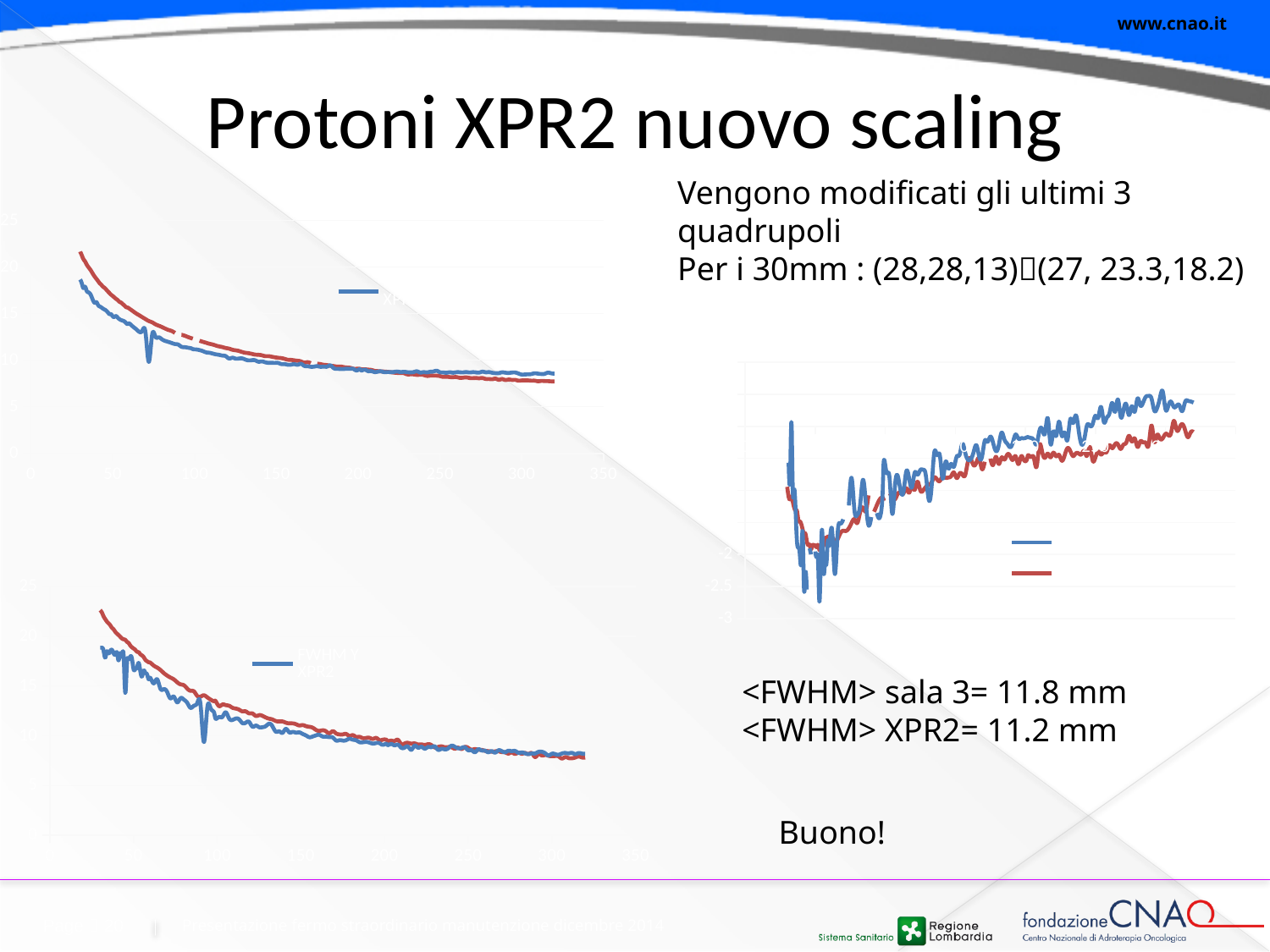
What kind of chart is the chart at the bottom left of the slide? line chart How many lines are plotted in the chart at the bottom left of the slide? 2 What legend entry is shown in the chart at the bottom left of the slide? FWHM Y XPR2 How many lines are plotted in the chart at the top left of the slide? 2 In the chart at the bottom left of the slide, do the plotted values rise or fall along the x axis? fall In the chart at the top left of the slide, do the plotted values rise or fall along the x axis? fall What two colours are used for the lines in the chart at the bottom left of the slide? blue and red What kind of chart is the chart at the top left of the slide? line chart In the chart on the right side of the slide, after the initial dip, do the plotted values rise or fall along the x axis? rise What kind of chart is the chart on the right side of the slide? line chart How many lines are plotted in the chart on the right side of the slide? 2